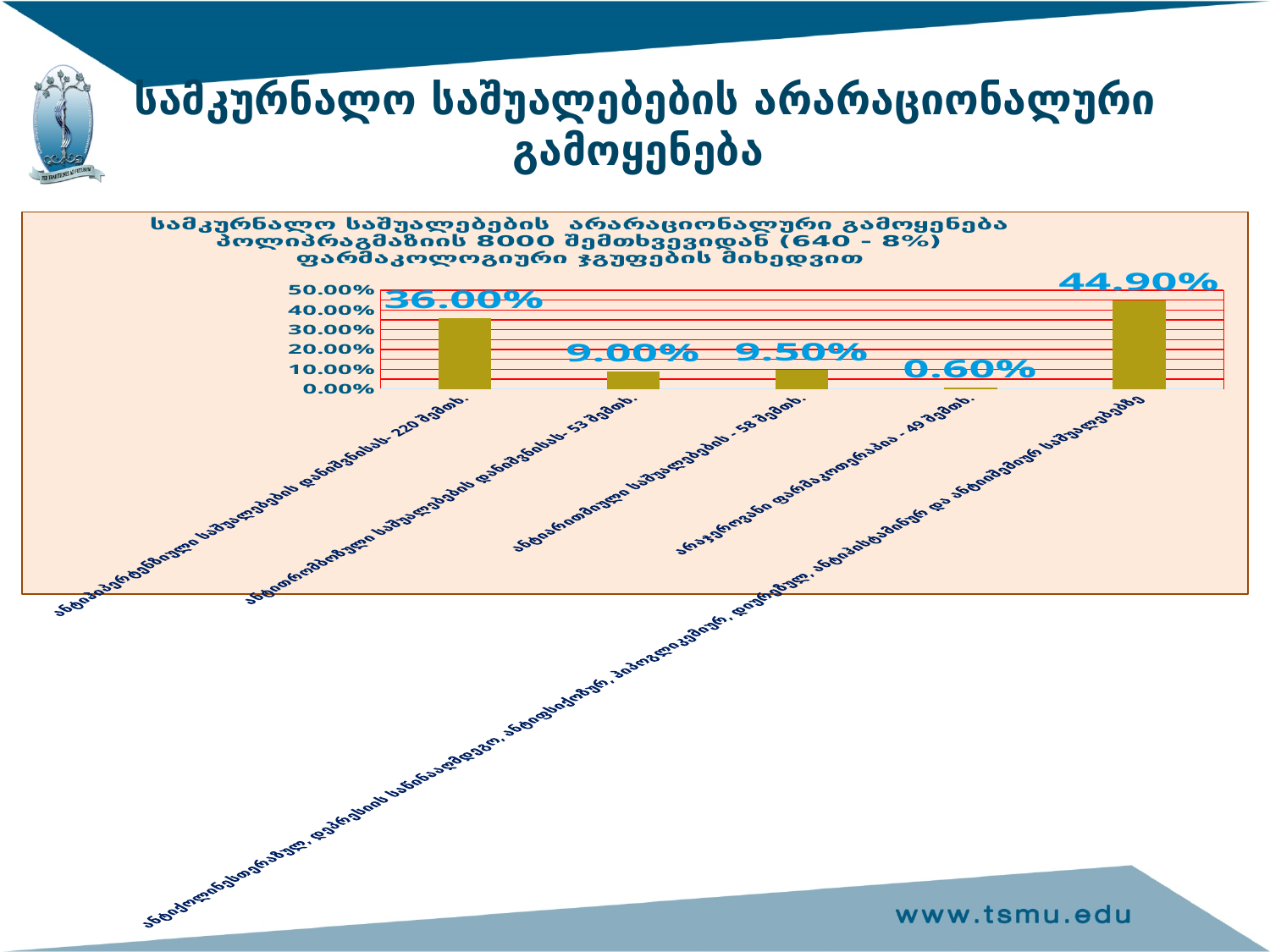
What is the difference between the highest value (44.90%) and the first bar (36.00%)? 8.90% What is the value of the fourth bar, for irrational pharmacotherapy (49 cases)? 0.60% How many bars (categories) does the chart show? 5 What is the highest value shown on the vertical axis? 50.00% What is the value of the second bar, for antithrombotic drugs (53 cases)? 9.00% Which bar has the highest value? the last (rightmost) bar, 44.90% Which bar has the lowest value? the fourth bar (49 cases), 0.60% Which is larger: the value for the second bar (53 cases) or the third bar (58 cases)? the third bar, 9.50% What is the value of the last (rightmost) bar? 44.90% What type of chart is shown on the slide? bar chart What is the value of the first (leftmost) bar, for antihypertensive drugs (220 cases)? 36.00% What is the value of the third bar, for antiarrhythmic drugs (58 cases)? 9.50%